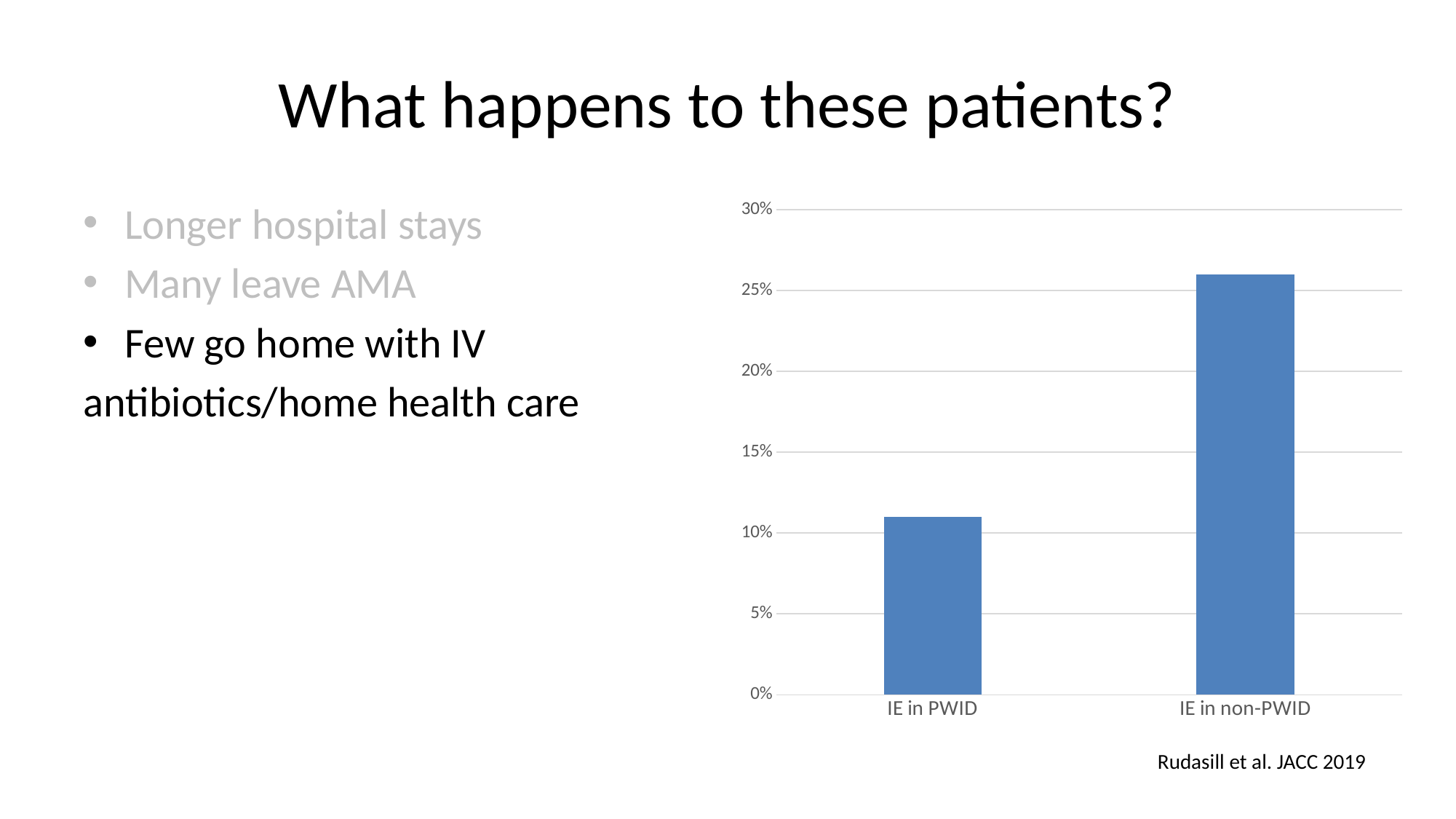
What is the highest value shown on the chart's vertical axis? 30% Which category has the highest value in the bar chart? IE in non-PWID Is the value for IE in PWID greater or less than 10%? greater Which category has the lowest value in the bar chart? IE in PWID How many categories are plotted in the bar chart? 2 Is the value for IE in non-PWID greater or less than 25%? greater Is the value for IE in non-PWID greater or less than 30%? less What is the label of the left-hand bar in the chart? IE in PWID What kind of chart is shown on the slide? bar chart Do the bar values rise or fall from left to right along the x axis? rise Which is larger, the value for IE in PWID or the value for IE in non-PWID? IE in non-PWID